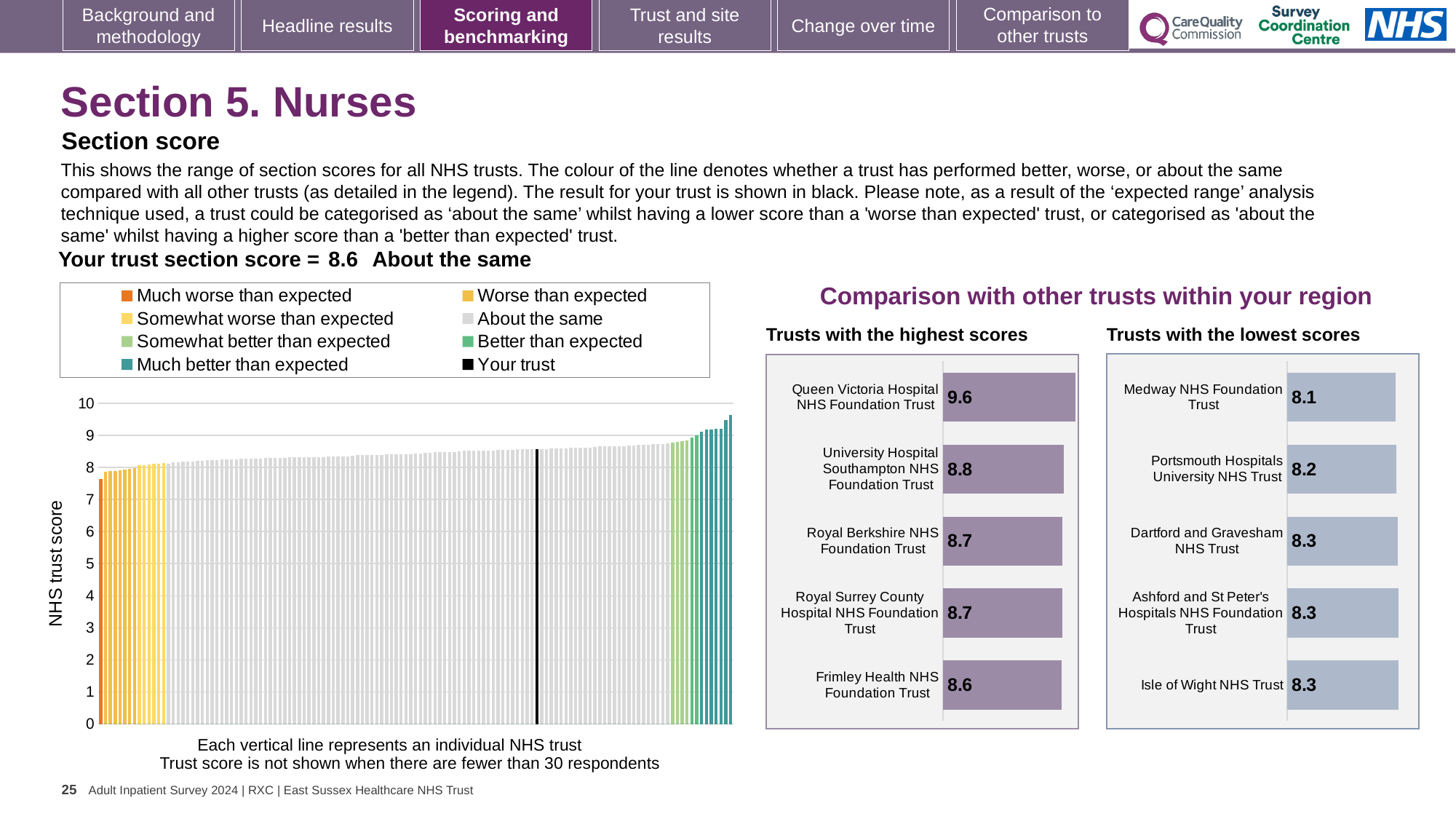
In the 'Trusts with the lowest scores' chart, which has the larger score: Portsmouth Hospitals University NHS Trust or Medway NHS Foundation Trust? Portsmouth Hospitals University NHS Trust In the 'Trusts with the lowest scores' chart, what is the score for Medway NHS Foundation Trust? 8.1 How many entries does the legend of the main section score chart list? 8 In the 'Trusts with the highest scores' chart, what is the score for Frimley Health NHS Foundation Trust? 8.6 How many trusts are shown in the 'Trusts with the highest scores' chart? 5 In the 'Trusts with the highest scores' chart, what is the difference between the scores of Queen Victoria Hospital NHS Foundation Trust and University Hospital Southampton NHS Foundation Trust? 0.8 In the 'Trusts with the lowest scores' chart, which trust has the lowest score? Medway NHS Foundation Trust What type of chart is the 'Trusts with the lowest scores' chart? Bar chart In the 'Trusts with the highest scores' chart, what is the score for Queen Victoria Hospital NHS Foundation Trust? 9.6 In the 'Trusts with the highest scores' chart, which trust has the highest score? Queen Victoria Hospital NHS Foundation Trust In the 'Trusts with the lowest scores' chart, what is the difference between the scores of Isle of Wight NHS Trust and Medway NHS Foundation Trust? 0.2 In the main section score chart, do the trust scores rise or fall from left to right along the x axis? Rise